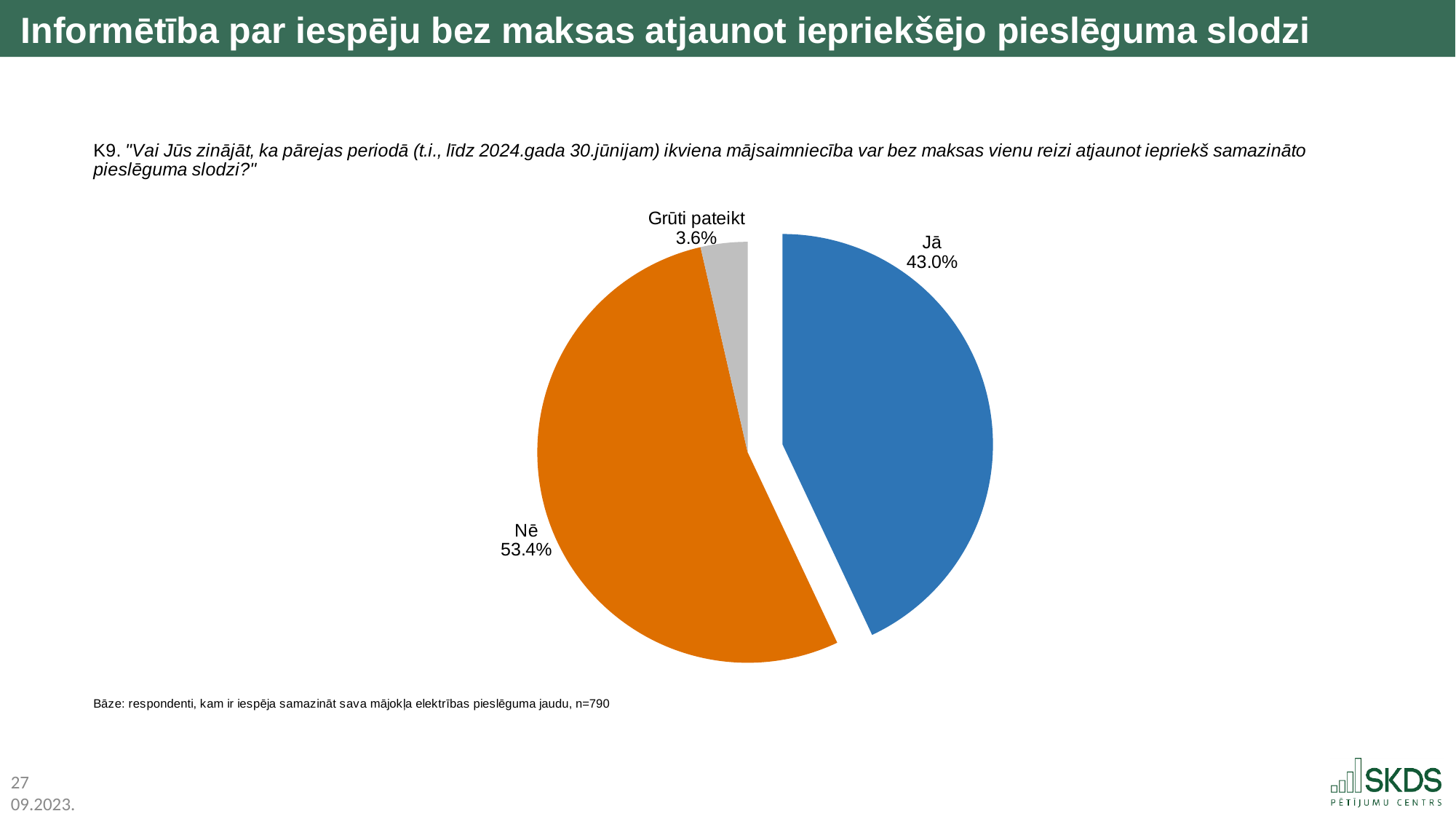
What is the difference in percentage points between the "Nē" and "Jā" shares? 10.4 What kind of chart is shown on the slide? pie chart What colour is the "Nē" slice? orange What is the difference in percentage points between the "Jā" and "Grūti pateikt" shares? 39.4 How many slices does the pie chart have? 3 Which answer has the largest share of the pie? Nē What share of respondents answered "Jā"? 43.0% What share of respondents answered "Nē"? 53.4% What share of respondents answered "Grūti pateikt"? 3.6% Which answer has the smallest share of the pie? Grūti pateikt Which is larger, the share for "Jā" or the share for "Nē"? Nē What is the sample size (n) stated in the base note below the chart? 790